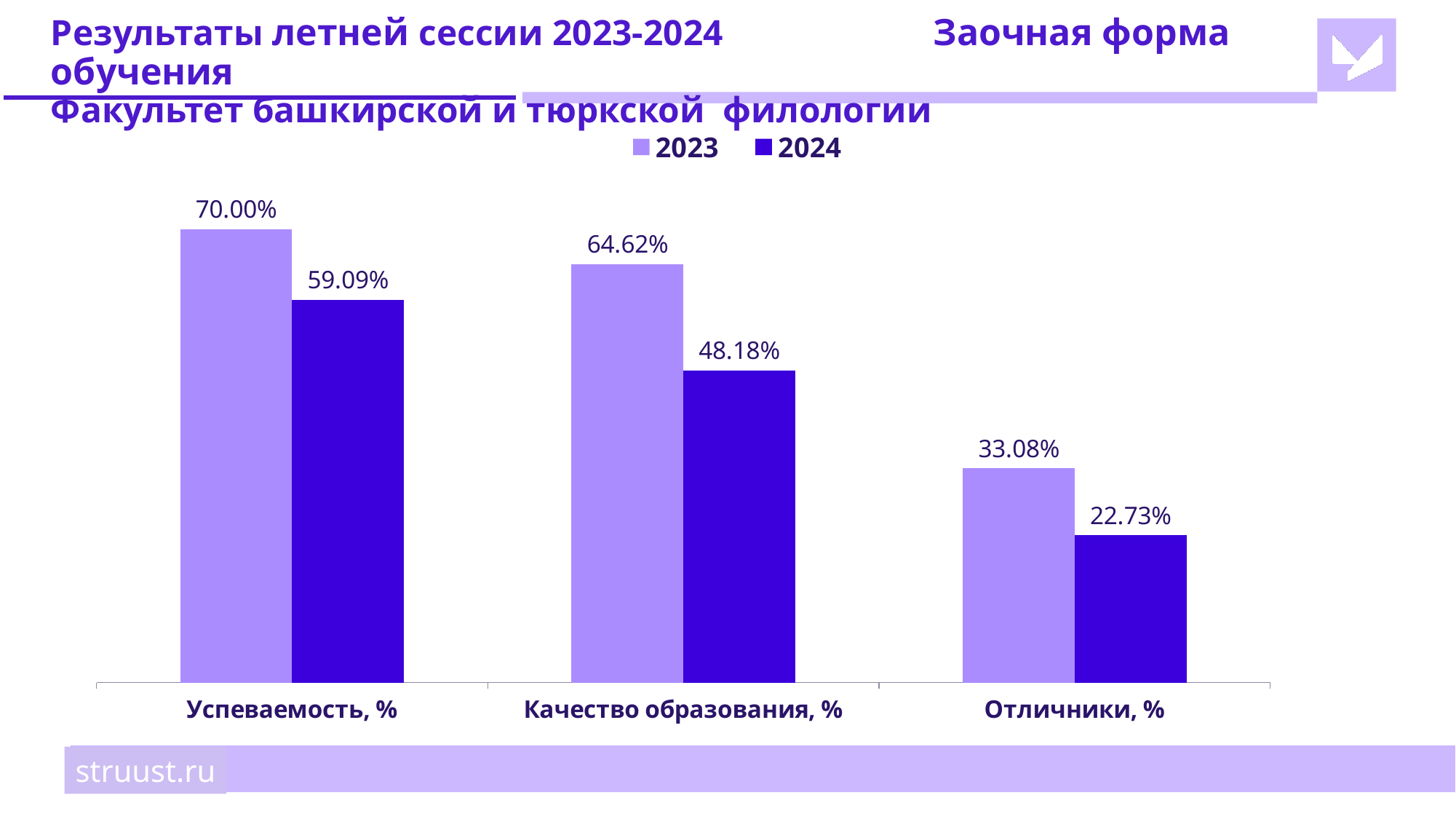
Which is larger for Качество образования, %: the 2023 value or the 2024 value? 2023 How many categories are shown on the x axis? 3 What is the 2024 value for Качество образования, %? 48.18% What is the 2023 value for Качество образования, %? 64.62% What is the 2023 value for Успеваемость, %? 70.00% What kind of chart is shown on the slide? Bar chart Which category has the highest 2024 value? Успеваемость, % How many series does the legend list? 2 What is the difference between the 2023 and 2024 values for Отличники, %? 10.35% What is the difference between the 2023 and 2024 values for Успеваемость, %? 10.91% Which category has the lowest 2023 value? Отличники, % What is the 2024 value for Отличники, %? 22.73%